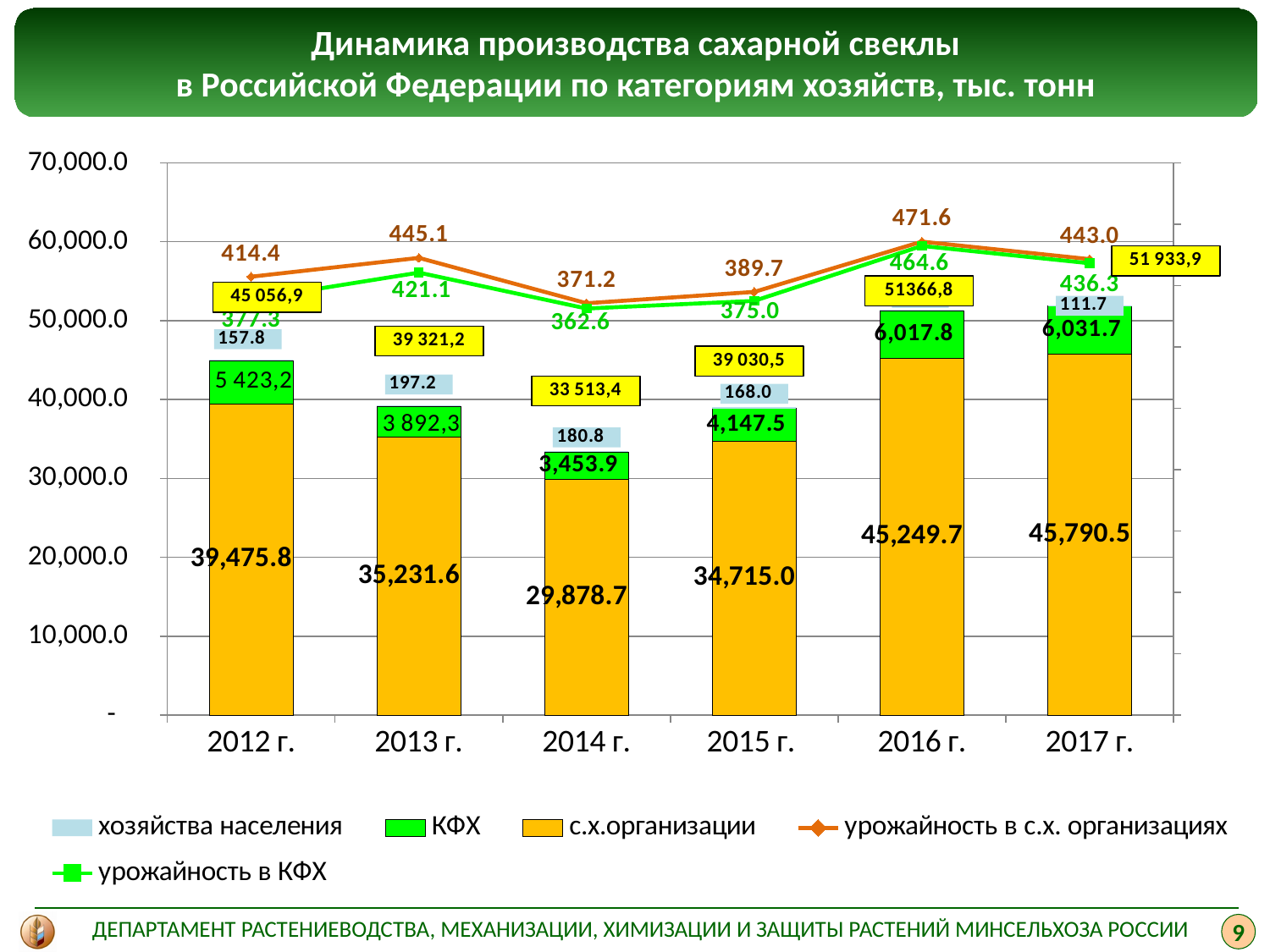
What is the value of урожайность в с.х. организациях in 2016 г.? 471.6 What is the difference between the с.х.организации values for 2017 г. and 2016 г.? 540.8 In which year is the value for с.х.организации the highest? 2017 г. Does the value for с.х.организации rise or fall from 2014 г. to 2017 г.? Rise What is the value for с.х.организации in 2014 г.? 29,878.7 What is the total of the stacked bar for 2012 г.? 45 056,9 In which year is the total production (sum of the stacked bar) the lowest? 2014 г. Which year has the larger value for урожайность в КФХ, 2013 г. or 2015 г.? 2013 г. What is the value for хозяйства населения in 2013 г.? 197.2 What kind of chart is shown on the slide? Combined stacked bar and line chart How many years are shown on the x axis? 6 How many series does the legend list? 5